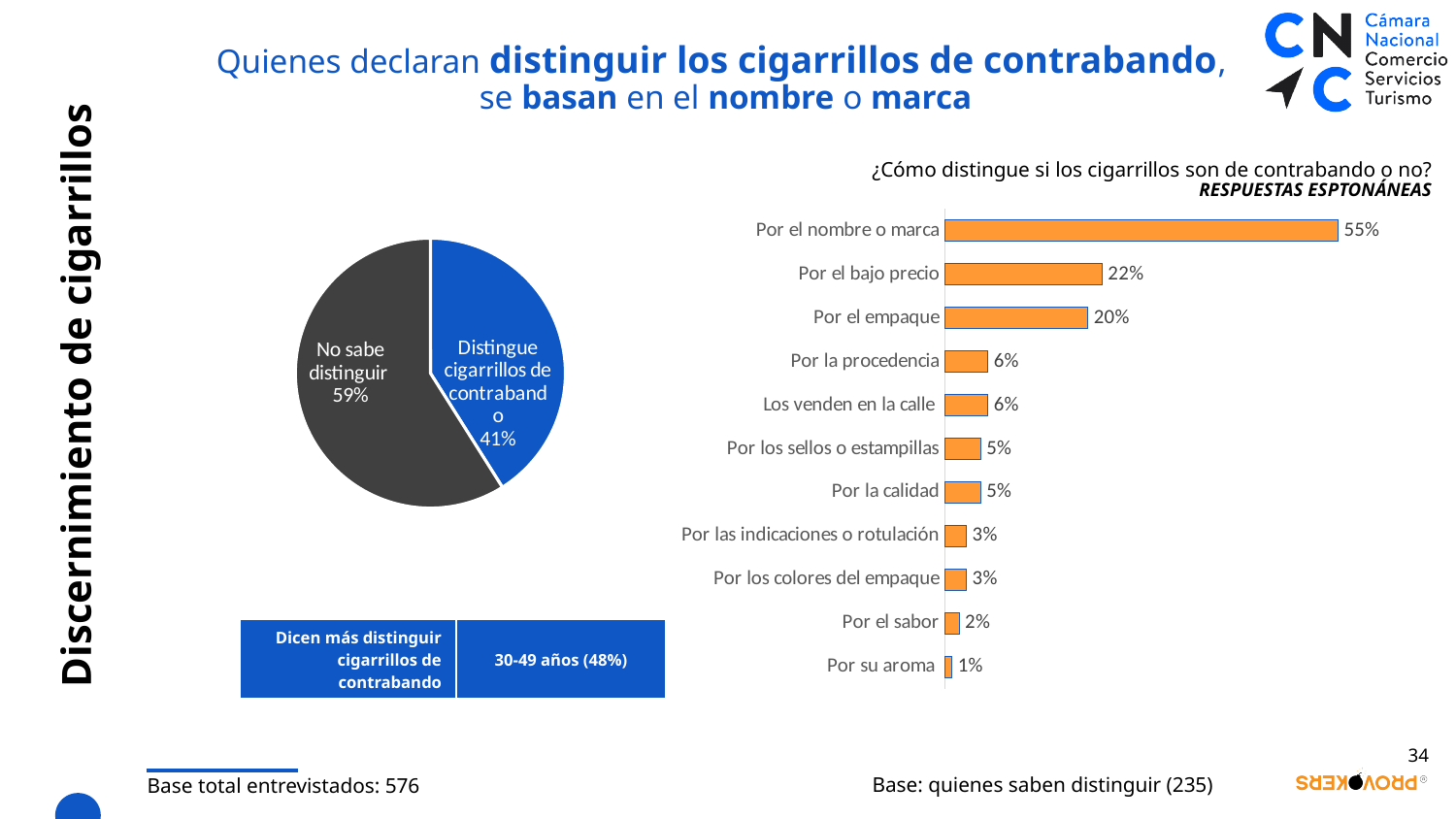
What type of chart is shown on the right side of the slide? Bar chart In the bar chart '¿Cómo distingue si los cigarrillos son de contrabando o no?', which is larger: 'Por el bajo precio' or 'Por el empaque'? Por el bajo precio In the pie chart on the left, what share of respondents say they do not know how to distinguish contraband cigarettes (No sabe distinguir)? 59% In the bar chart '¿Cómo distingue si los cigarrillos son de contrabando o no?', what is the difference between 'Por el nombre o marca' and 'Por el bajo precio'? 33% In the bar chart '¿Cómo distingue si los cigarrillos son de contrabando o no?', which category has the highest value? Por el nombre o marca How many categories are shown in the bar chart '¿Cómo distingue si los cigarrillos son de contrabando o no?'? 11 What type of chart is shown on the left side of the slide? Pie chart In the bar chart '¿Cómo distingue si los cigarrillos son de contrabando o no?', which category has the lowest value? Por su aroma In the bar chart '¿Cómo distingue si los cigarrillos son de contrabando o no?', what is the value for 'Por el nombre o marca'? 55% In the pie chart on the left, what share of respondents say they can distinguish contraband cigarettes (Distingue cigarrillos de contrabando)? 41% In the pie chart on the left, which slice is larger: 'No sabe distinguir' or 'Distingue cigarrillos de contrabando'? No sabe distinguir In the bar chart '¿Cómo distingue si los cigarrillos son de contrabando o no?', what is the value for 'Por el empaque'? 20%